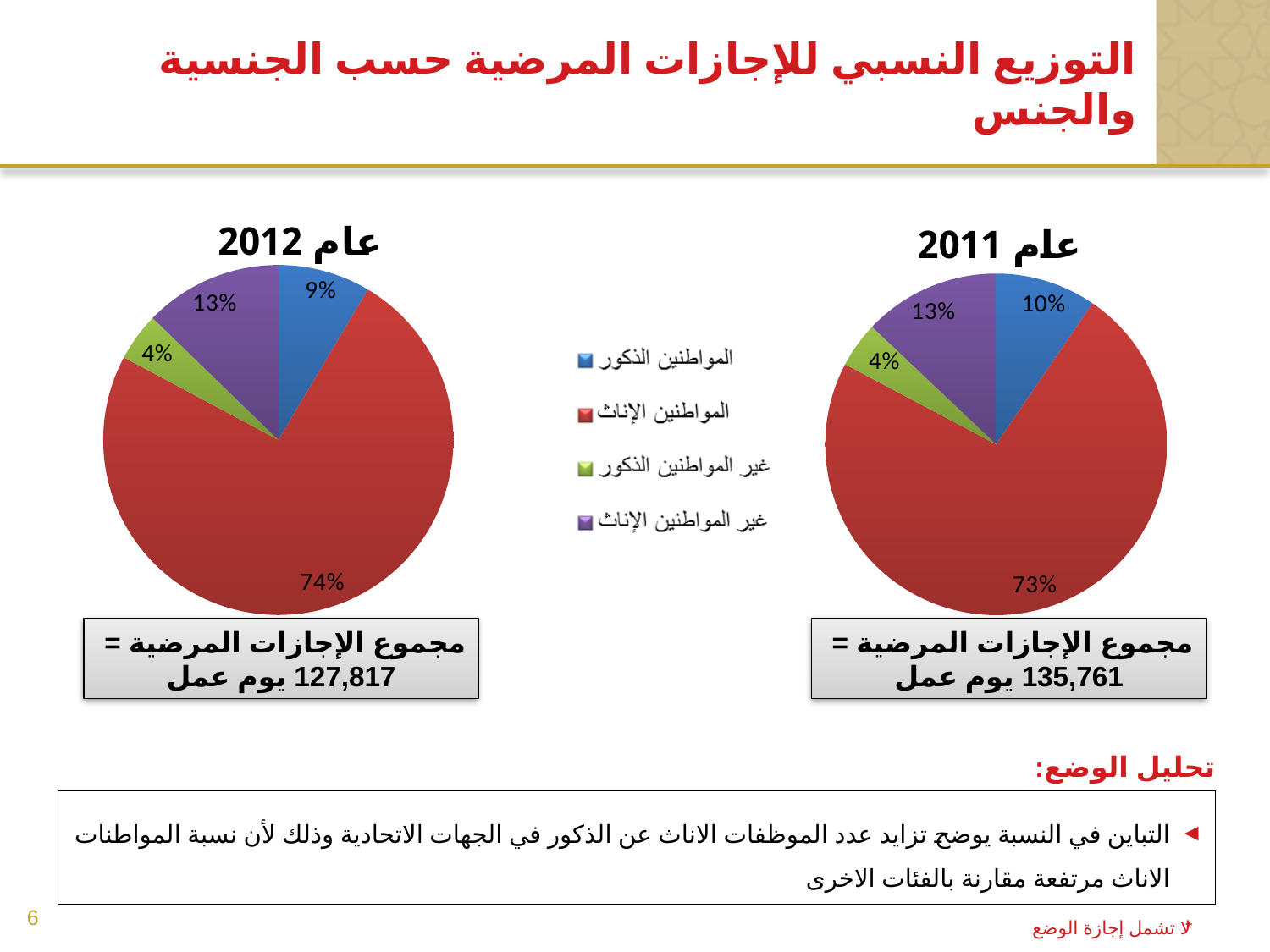
In the "عام 2012" chart, what share does المواطنين الإناث have? 74% In the "عام 2012" chart, what is the difference between the shares of غير المواطنين الإناث and المواطنين الذكور? 4% How many categories does the legend list for the pie charts? 4 In the "عام 2011" chart, what share does المواطنين الإناث have? 73% What type of chart is used for the "عام 2012" chart? pie chart In the "عام 2012" chart, which category has the largest share? المواطنين الإناث In the "عام 2011" chart, which is larger: the share of المواطنين الذكور or the share of غير المواطنين الذكور? المواطنين الذكور In the "عام 2011" chart, which category has the smallest share? غير المواطنين الذكور In the "عام 2011" chart, what share does غير المواطنين الإناث have? 13% Which colour represents المواطنين الإناث in the pie charts? red